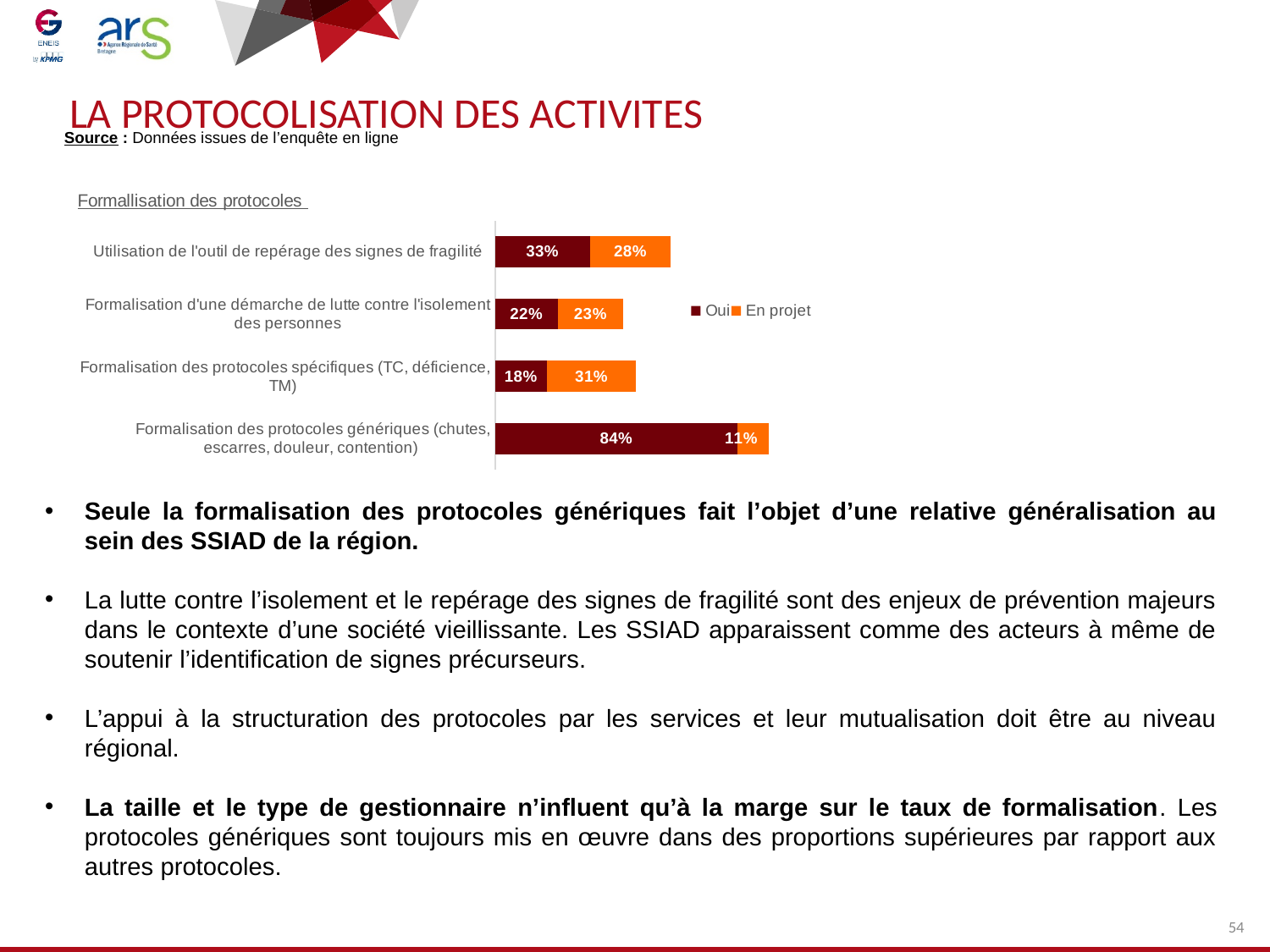
What is the "Oui" value for "Formalisation des protocoles génériques (chutes, escarres, douleur, contention)"? 84% What is the "Oui" value for "Formalisation des protocoles spécifiques (TC, déficience, TM)"? 18% What is the "En projet" value for "Formalisation d'une démarche de lutte contre l'isolement des personnes"? 23% What is the combined total of "Oui" and "En projet" for "Formalisation des protocoles génériques (chutes, escarres, douleur, contention)"? 95% What is the difference between the "Oui" and "En projet" values for "Formalisation des protocoles spécifiques (TC, déficience, TM)"? 13% How many series does the legend list? 2 Which category has the lowest "Oui" value? Formalisation des protocoles spécifiques (TC, déficience, TM) What is the "En projet" value for "Utilisation de l'outil de repérage des signes de fragilité"? 28% How many categories are shown in the chart? 4 Which is larger for "Utilisation de l'outil de repérage des signes de fragilité": the "Oui" value or the "En projet" value? Oui Which category has the highest "Oui" value? Formalisation des protocoles génériques (chutes, escarres, douleur, contention) What type of chart is shown on the slide? Stacked bar chart